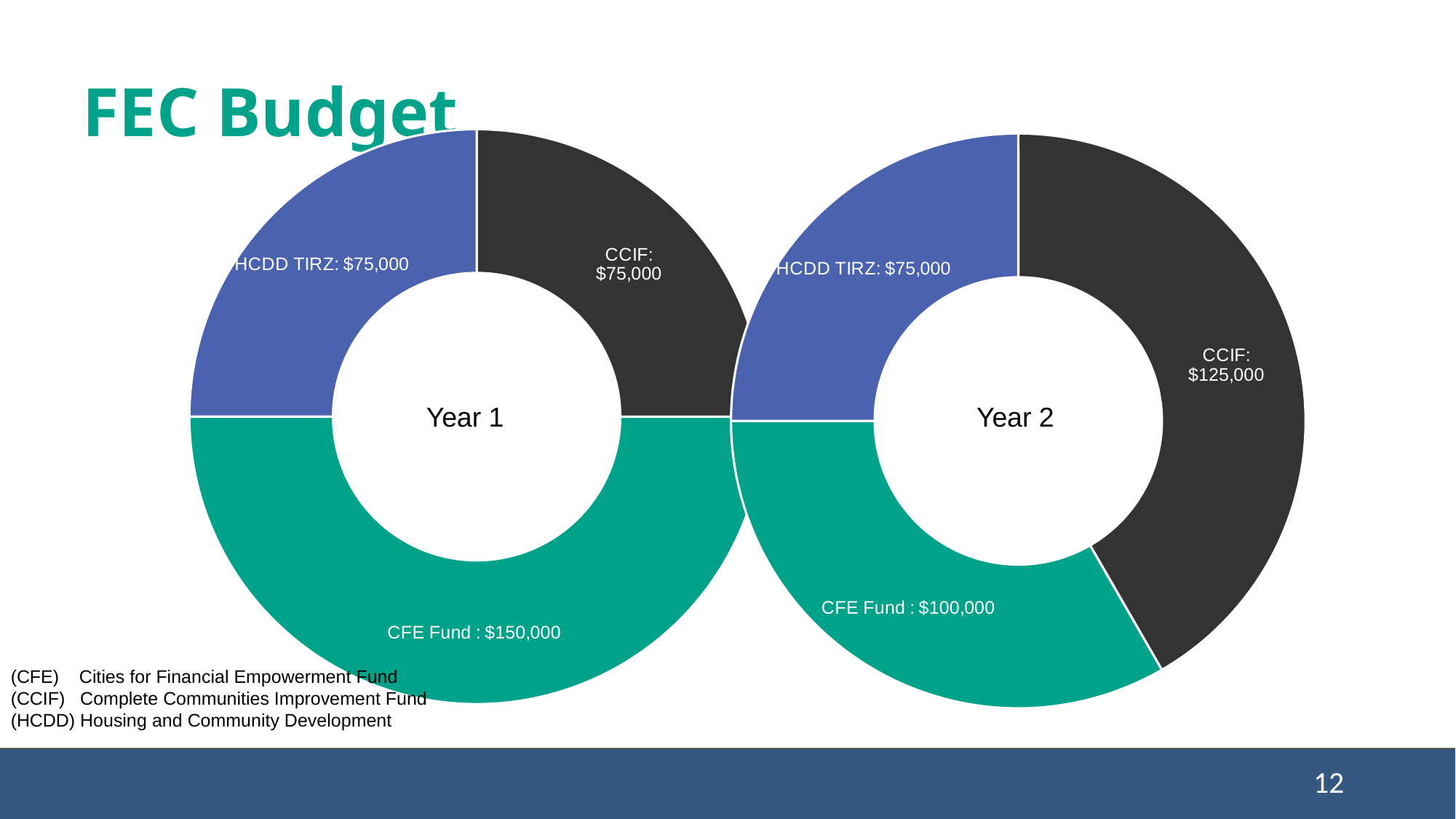
What is the total of all segments in the Year 2 chart? $300,000 In the Year 2 chart, what is the value for CCIF? $125,000 In the Year 2 chart, what is the difference between the CCIF value and the CFE Fund value? $25,000 What kind of chart is used for Year 1 and Year 2? Donut (pie) chart In the Year 1 chart, what share of the total does CFE Fund represent? 50% In the Year 2 chart, what is the value for HCDD TIRZ? $75,000 In the Year 1 chart, which category has the largest value? CFE Fund In the Year 2 chart, which category has the smallest value? HCDD TIRZ How many categories does the Year 1 chart show? 3 Is the CFE Fund value larger in the Year 1 chart or the Year 2 chart? Year 1 In the Year 1 chart, what is the value for CFE Fund? $150,000 In the Year 2 chart, which category has the largest value? CCIF